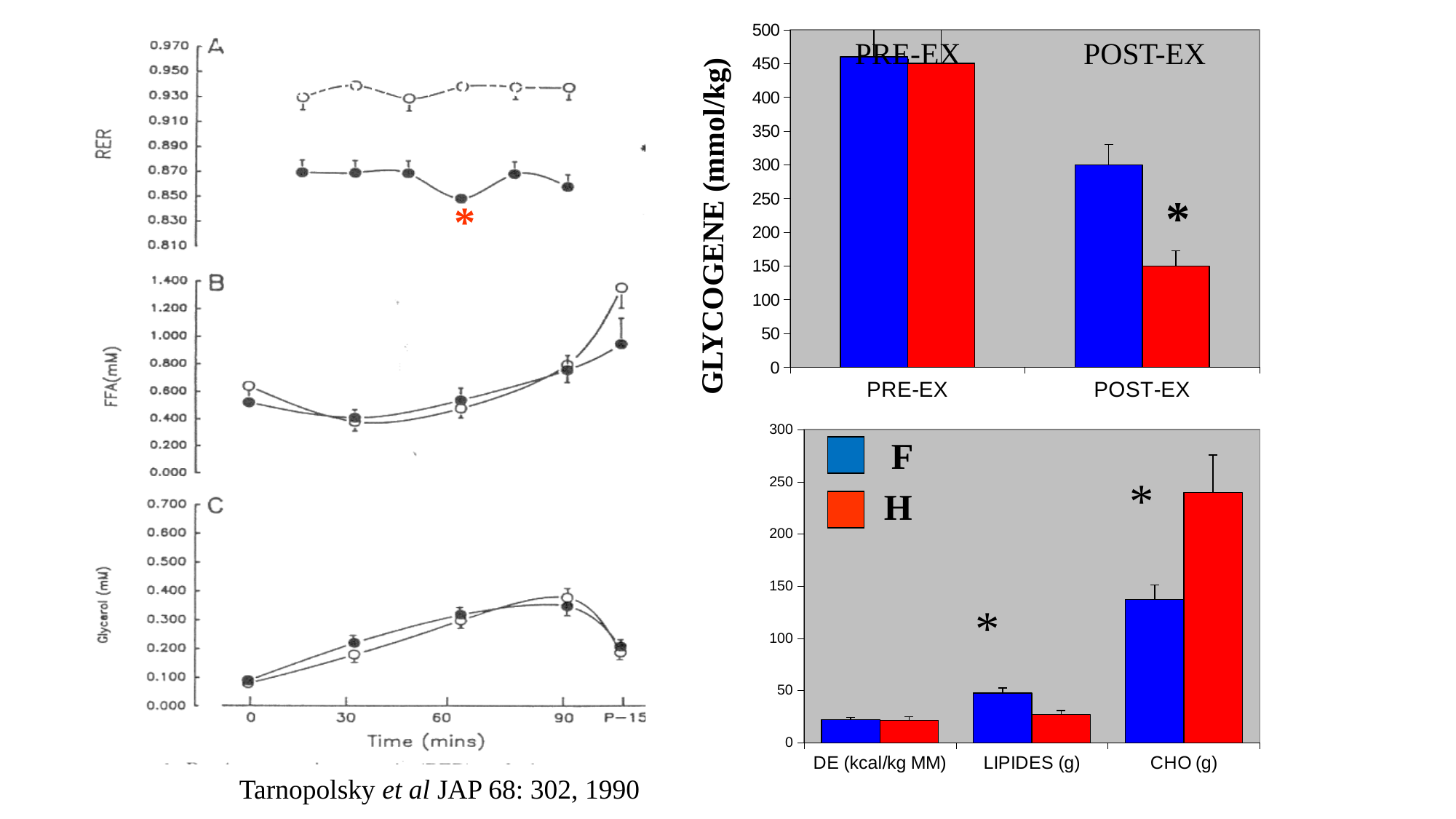
In the bottom-right bar chart, is the blue (F) bar for CHO (g) greater or less than 150? less In the bottom-right bar chart, how many series does the legend list? 2 In the left-hand panel C (Glycerol), do the values rise or fall from 0 to 90 minutes? rise What kind of chart is the top-right chart titled GLYCOGENE (mmol/kg)? bar chart In the top-right GLYCOGENE chart, which POST-EX bar is larger, the blue (F) or the red (H)? blue (F) What is the y-axis label of the top-right bar chart? GLYCOGENE (mmol/kg) In the top-right GLYCOGENE chart, is the red (H) POST-EX bar greater or less than 200? less In the bottom-right bar chart, which category has the highest red (H) bar? CHO (g) In the bottom-right bar chart, how many categories are shown on the x axis? 3 In the bottom-right bar chart, for LIPIDES (g), which bar is larger, blue (F) or red (H)? blue (F) In the top-right GLYCOGENE chart, is the blue (F) PRE-EX bar greater or less than 400? greater